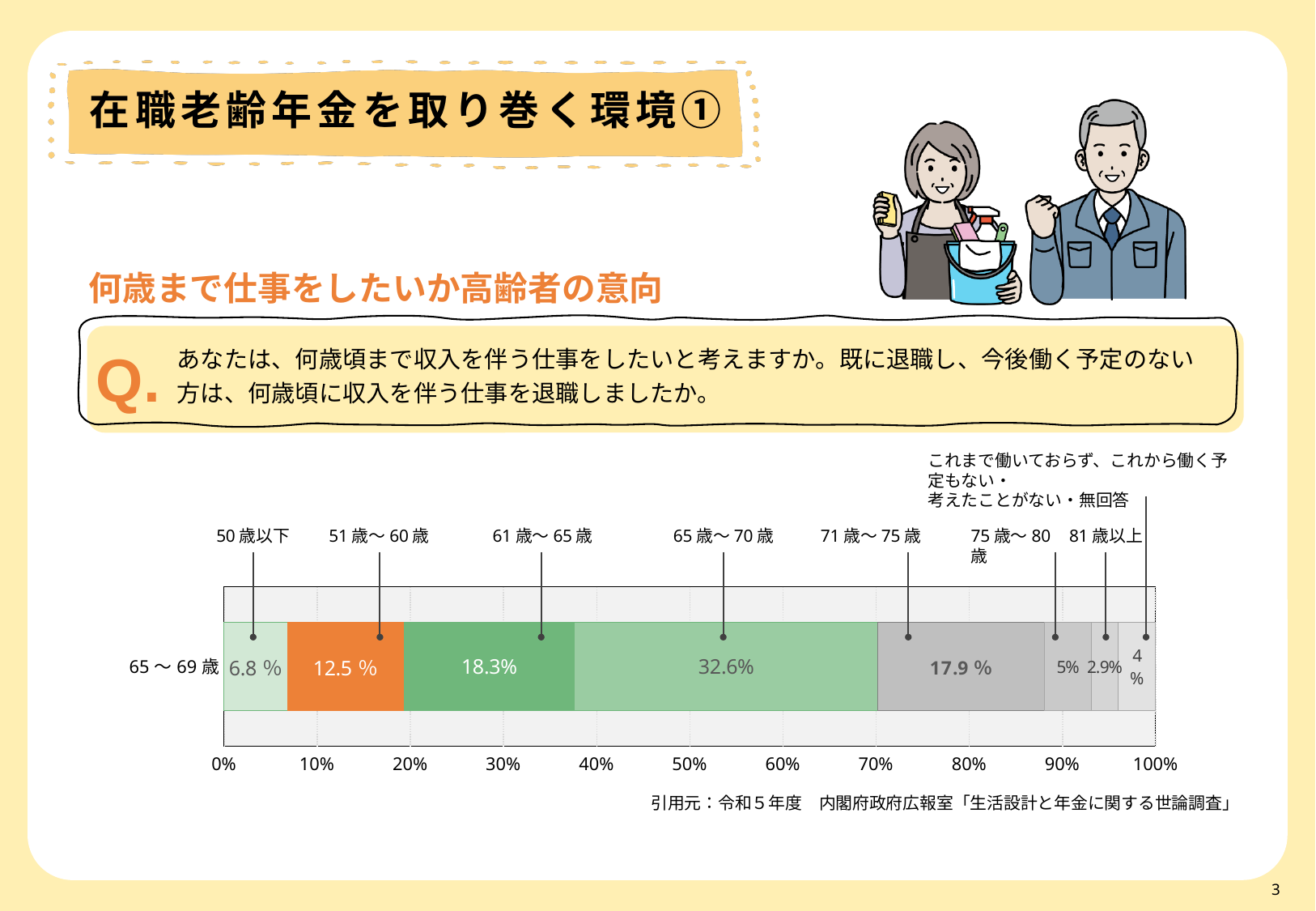
Which age group does the single bar in the chart represent? 65〜69歳 How many segments make up the stacked bar? 8 What percentage of respondents aged 65–69 answered 65歳〜70歳? 32.6% What kind of chart is shown on the slide? Stacked bar chart What percentage is shown for the 50歳以下 segment? 6.8% What is the total of all segments in the stacked bar? 100% What is the value shown for the 71歳〜75歳 segment? 17.9% Which is larger, the share for 51歳〜60歳 or the share for 71歳〜75歳? 71歳〜75歳 Which response category has the largest share in the bar? 65歳〜70歳 Which response category has the smallest share in the bar? 81歳以上 What is the value shown for the 51歳〜60歳 segment? 12.5% What is the difference between the 65歳〜70歳 share and the 61歳〜65歳 share? 14.3%